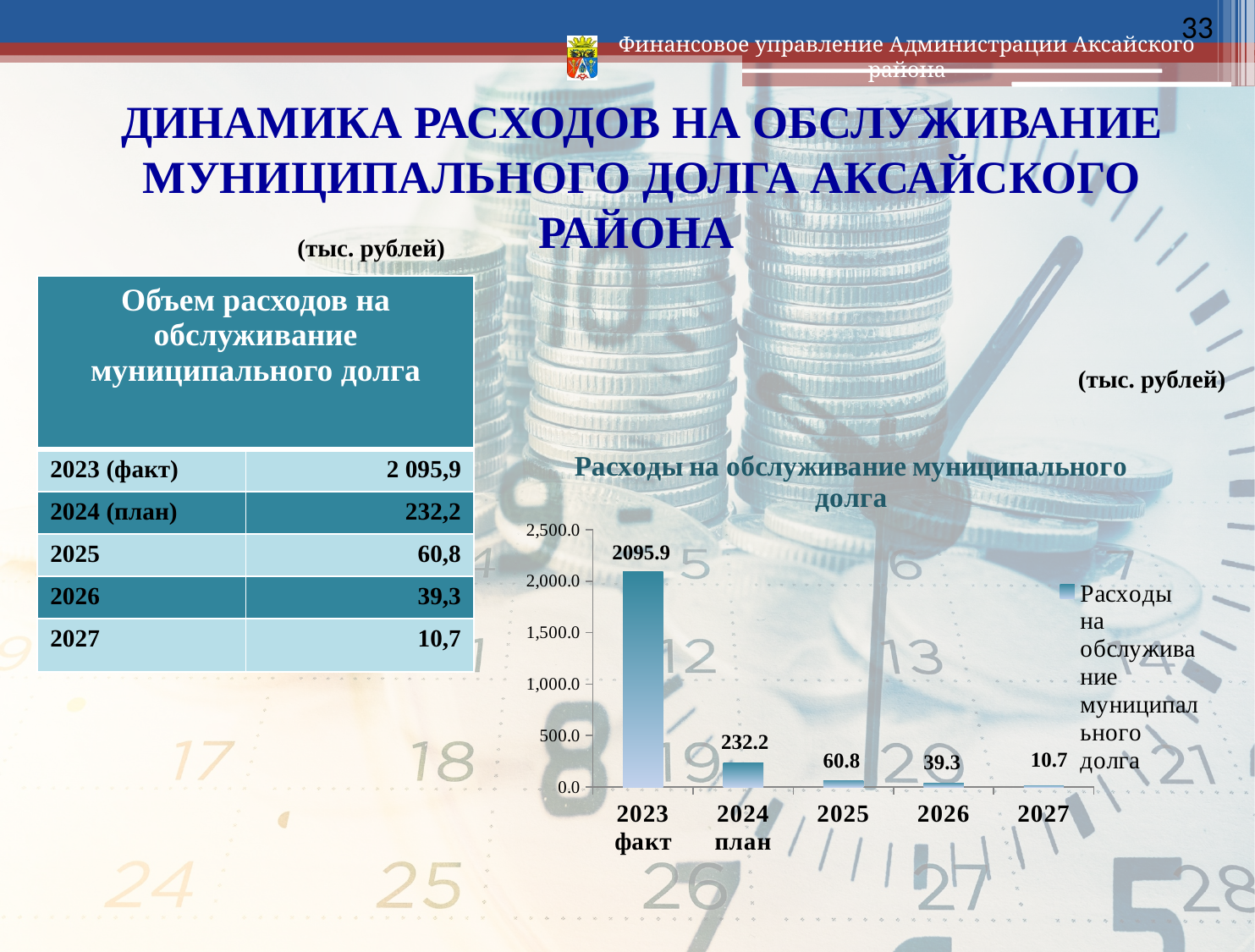
What is the difference between the values for 2023 факт and 2024 план? 1863.7 What is the value for 2024 план in the chart? 232.2 What is the difference between the values for 2026 and 2027? 28.6 Which category has the highest value in the chart? 2023 факт What is the value for 2023 факт in the chart? 2095.9 Do the values rise or fall from 2023 факт to 2027? fall What is the value for 2027 in the chart? 10.7 Which category has the lowest value in the chart? 2027 What type of chart is shown on the slide? bar chart Which is larger, the value for 2025 or the value for 2026? 2025 What is the value for 2025 in the chart? 60.8 How many categories are shown on the x axis of the chart? 5